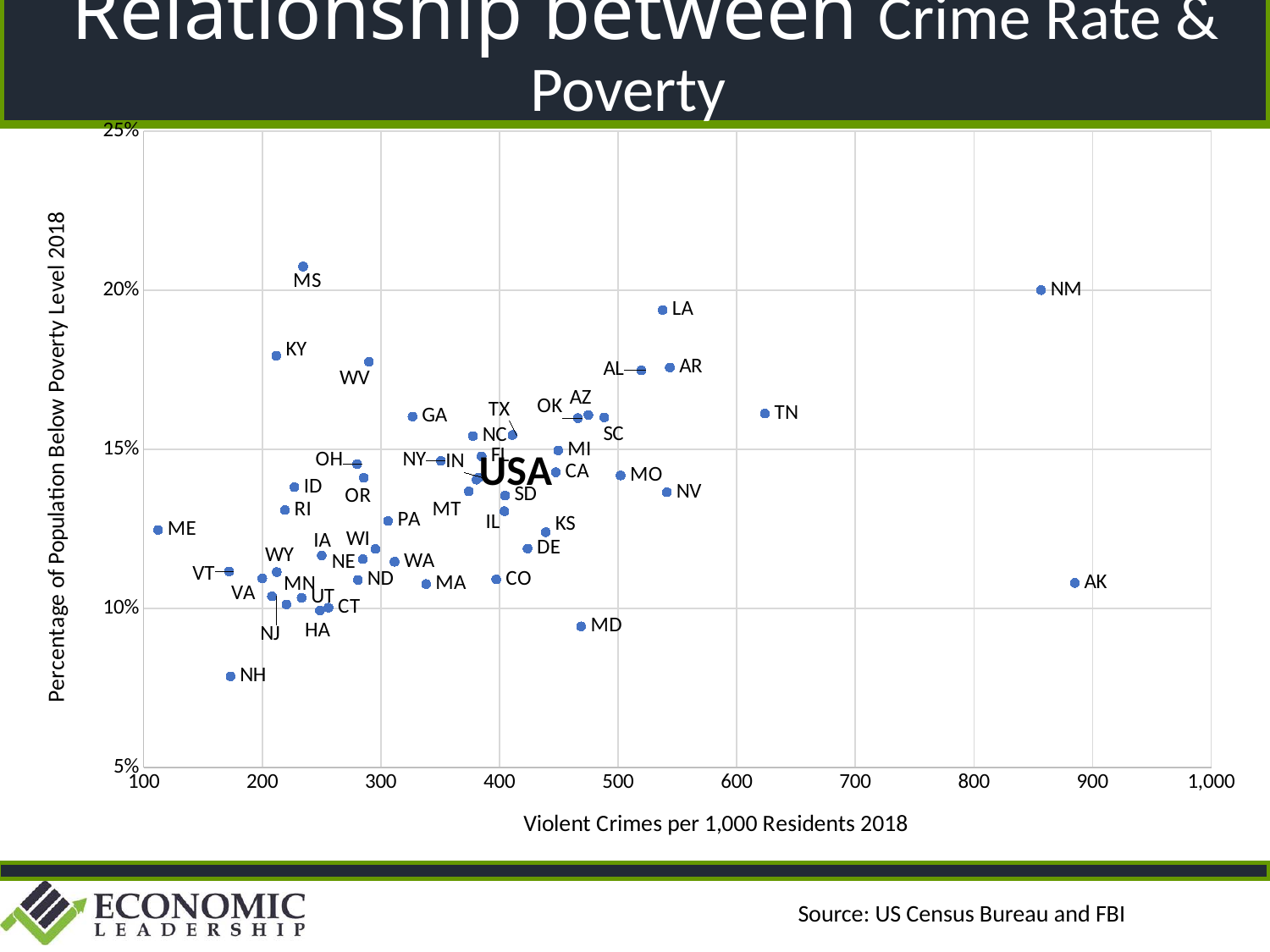
What is the title of the vertical axis? Percentage of Population Below Poverty Level 2018 What kind of chart is shown on the slide? scatter plot What is the title of the horizontal axis? Violent Crimes per 1,000 Residents 2018 Which state has the lowest violent crime rate? ME Which state has a higher poverty percentage, LA or NV? LA Is the violent crime rate for TN greater or less than 600? greater Which state has the highest percentage of population below the poverty level? MS Is the poverty percentage for NM greater or less than 15%? greater Is the poverty percentage for MD greater or less than 10%? less Which state has the lowest percentage of population below the poverty level? NH Which state has a higher violent crime rate, TN or GA? TN